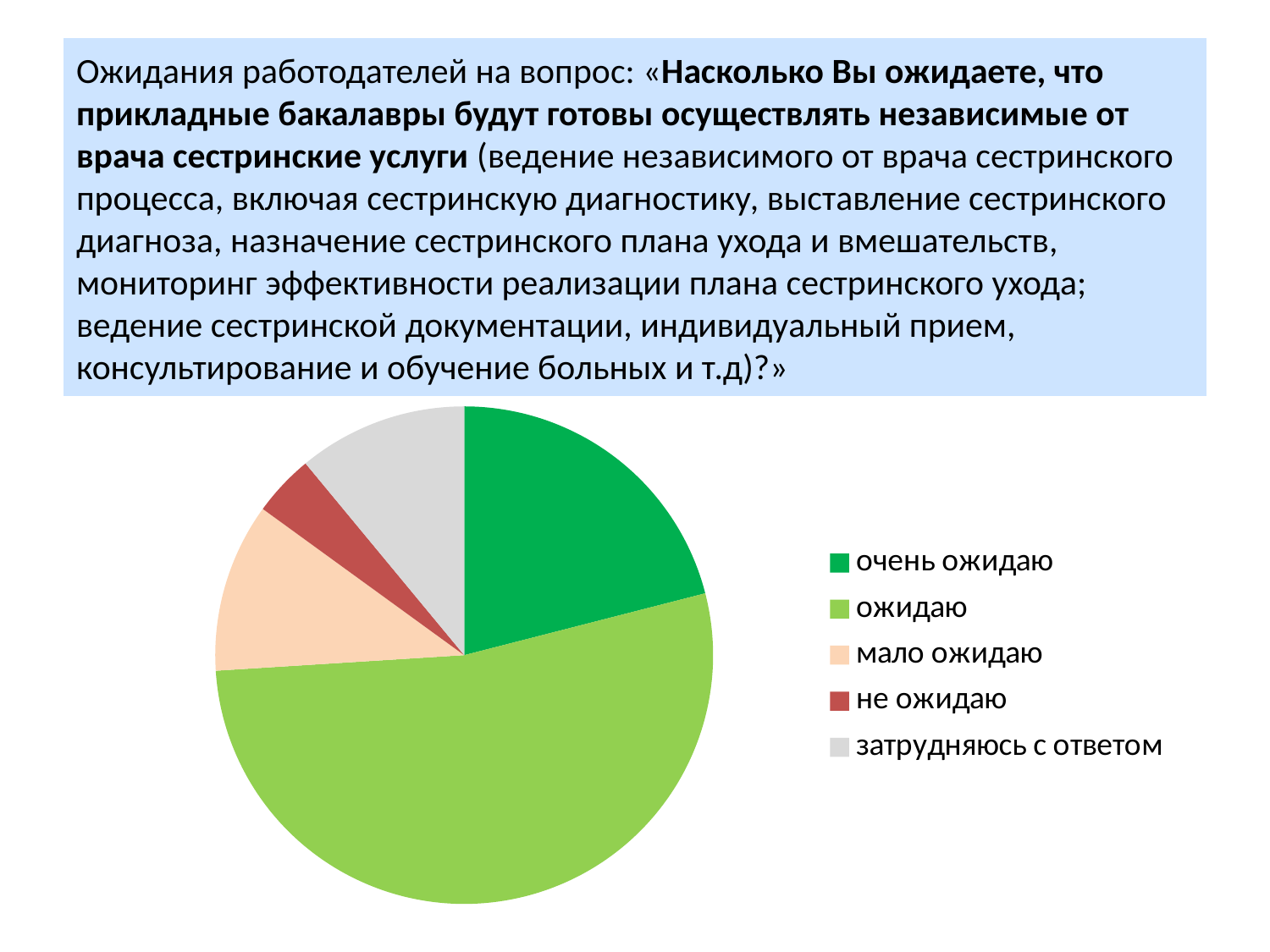
Which legend entry is listed last? затрудняюсь с ответом Which slice is larger: "очень ожидаю" or "мало ожидаю"? очень ожидаю Which slice is larger: "мало ожидаю" or "не ожидаю"? мало ожидаю Which category has the smallest slice of the pie? не ожидаю What colour is the "не ожидаю" slice? red Which category has the largest slice of the pie? ожидаю What kind of chart is shown on the slide? pie chart Is the "ожидаю" slice more or less than half of the pie? more Which slice is larger: "затрудняюсь с ответом" or "не ожидаю"? затрудняюсь с ответом How many slices does the pie chart have? 5